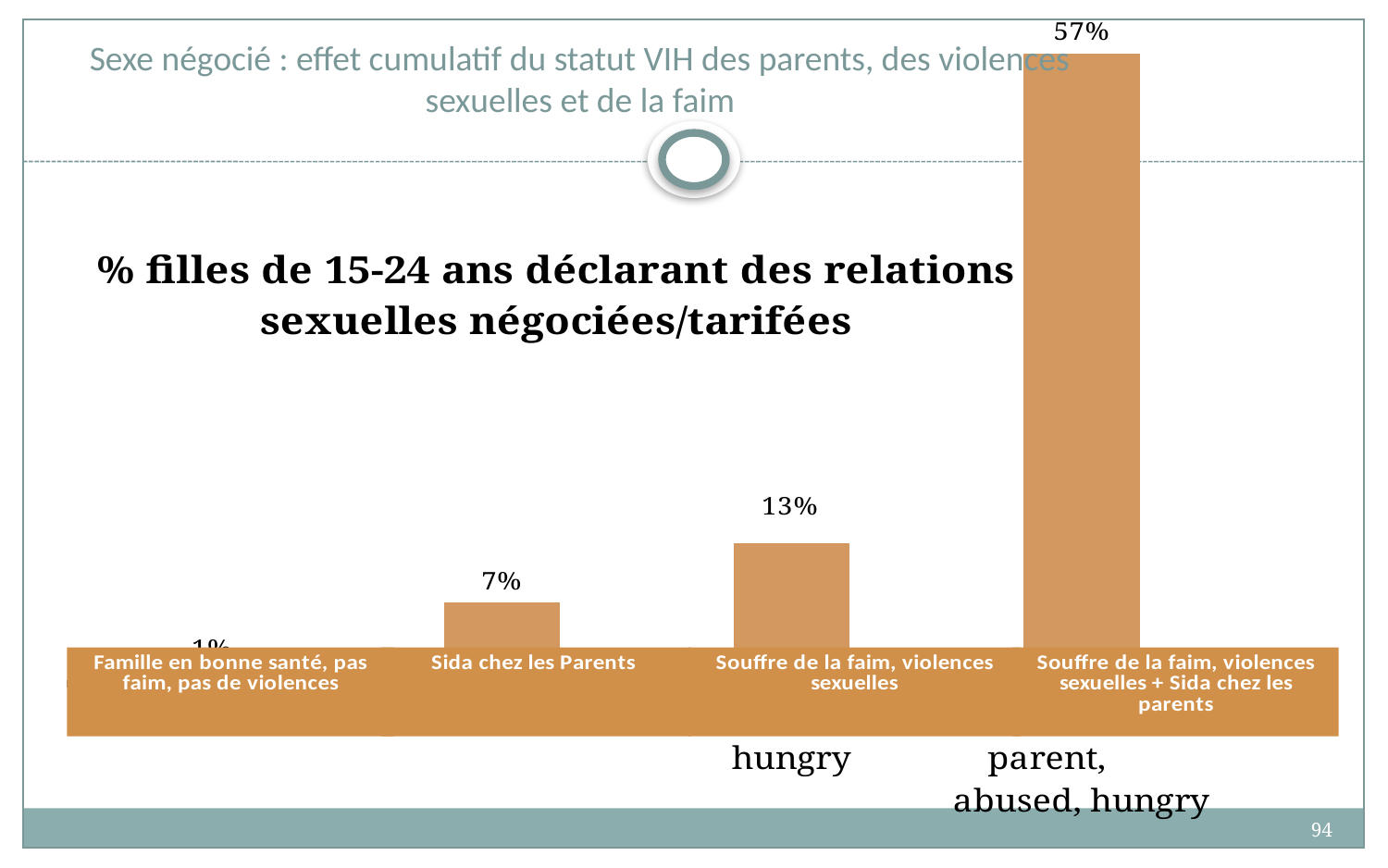
What is the title of the chart? % filles de 15-24 ans déclarant des relations sexuelles négociées/tarifées What kind of chart is shown on the slide? Bar chart What is the difference between the value for "Souffre de la faim, violences sexuelles" and the value for "Sida chez les Parents"? 6% Which is larger: the value for "Sida chez les Parents" or the value for "Souffre de la faim, violences sexuelles"? Souffre de la faim, violences sexuelles Which category has the highest value? Souffre de la faim, violences sexuelles + Sida chez les parents How many categories are shown in the chart? 4 Do the values rise or fall from left to right across the categories? Rise What is the value for "Souffre de la faim, violences sexuelles + Sida chez les parents"? 57% Which category has the lowest value? Famille en bonne santé, pas faim, pas de violences What is the value for "Sida chez les Parents"? 7% What is the difference between the value for "Souffre de la faim, violences sexuelles + Sida chez les parents" and the value for "Souffre de la faim, violences sexuelles"? 44% What is the value for "Souffre de la faim, violences sexuelles"? 13%